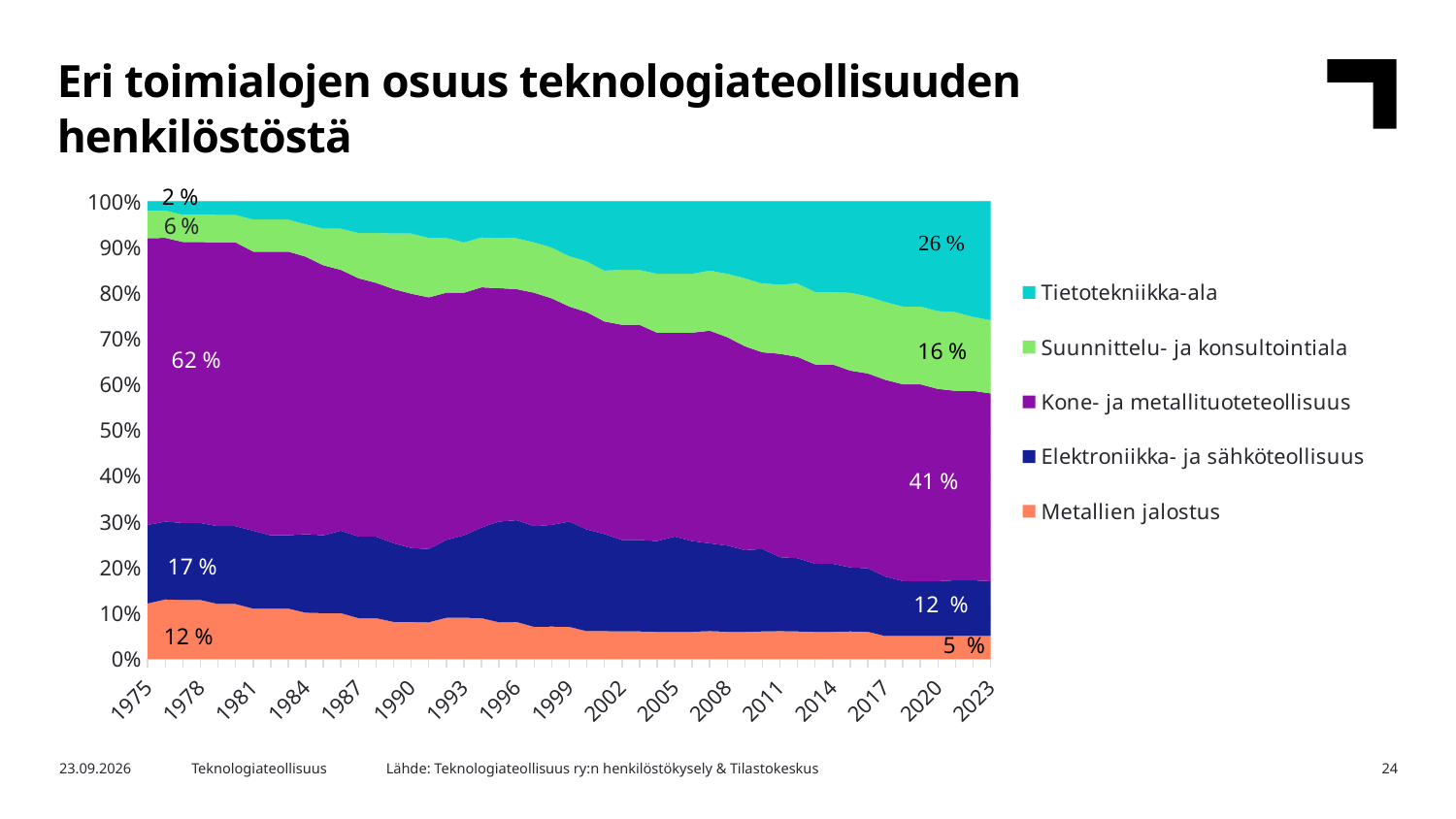
Does the share of Tietotekniikka-ala rise or fall from 1975 to 2023? Rise How many series does the legend list? 5 What is the title of the chart on the slide? Eri toimialojen osuus teknologiateollisuuden henkilöstöstä What share of technology industry personnel did Kone- ja metallituoteteollisuus have in 1975 according to the data label? 62 % What share does Tietotekniikka-ala have at the end of the series (2023) according to the data label? 26 % In 2023, which is larger: the share of Tietotekniikka-ala or the share of Suunnittelu- ja konsultointiala? Tietotekniikka-ala What share does Metallien jalostus have in 2023 according to the data label? 5 % What share did Suunnittelu- ja konsultointiala have in 1975 according to the data label? 6 % What kind of chart is shown on the slide? Stacked area chart Which sector had the smallest share in 1975? Tietotekniikka-ala By how many percentage points did the share of Kone- ja metallituoteteollisuus change between the 1975 label (62 %) and the 2023 label (41 %)? 21 percentage points Which sector had the largest share in 1975? Kone- ja metallituoteteollisuus